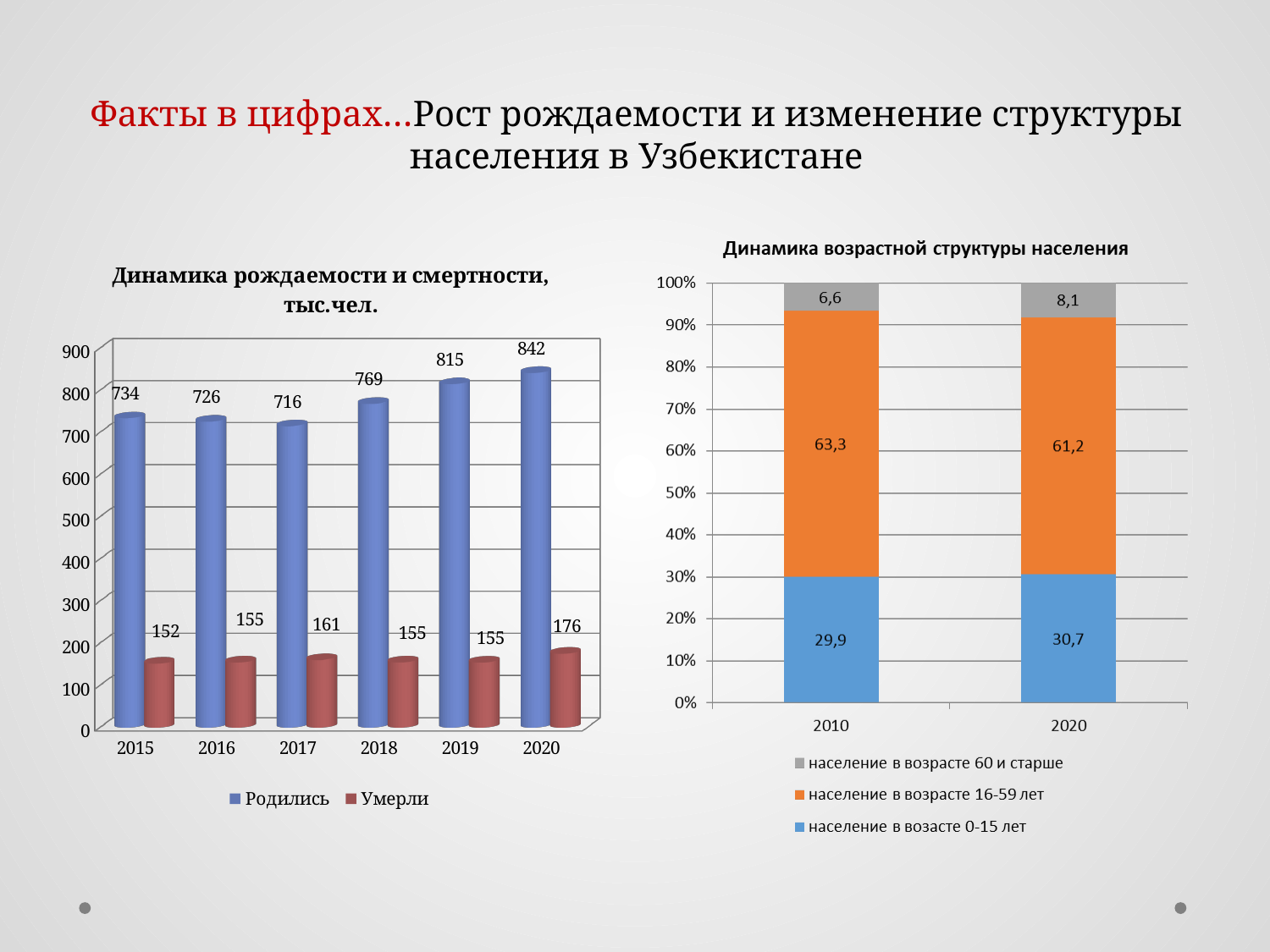
In the chart 'Динамика рождаемости и смертности, тыс.чел.', what is the difference between Родились and Умерли in 2019? 660 In the chart 'Динамика возрастной структуры населения', what is the value for население в возрасте 16-59 лет in 2020? 61,2 In the chart 'Динамика рождаемости и смертности, тыс.чел.', do the Родились values rise or fall from 2017 to 2020? rise In the chart 'Динамика рождаемости и смертности, тыс.чел.', which year has the lowest value for Родились? 2017 In the chart 'Динамика рождаемости и смертности, тыс.чел.', how many series does the legend list? 2 In the chart 'Динамика рождаемости и смертности, тыс.чел.', what is the value for Умерли in 2017? 161 In the chart 'Динамика возрастной структуры населения', which year has the larger value for население в возасте 0-15 лет, 2010 or 2020? 2020 In the chart 'Динамика возрастной структуры населения', what is the value for население в возрасте 60 и старше in 2010? 6,6 In the chart 'Динамика рождаемости и смертности, тыс.чел.', what is the value for Родились in 2020? 842 In the chart 'Динамика рождаемости и смертности, тыс.чел.', how many years are shown on the x axis? 6 In the chart 'Динамика рождаемости и смертности, тыс.чел.', which year has the highest value for Умерли? 2020 What kind of chart is 'Динамика возрастной структуры населения'? stacked bar chart